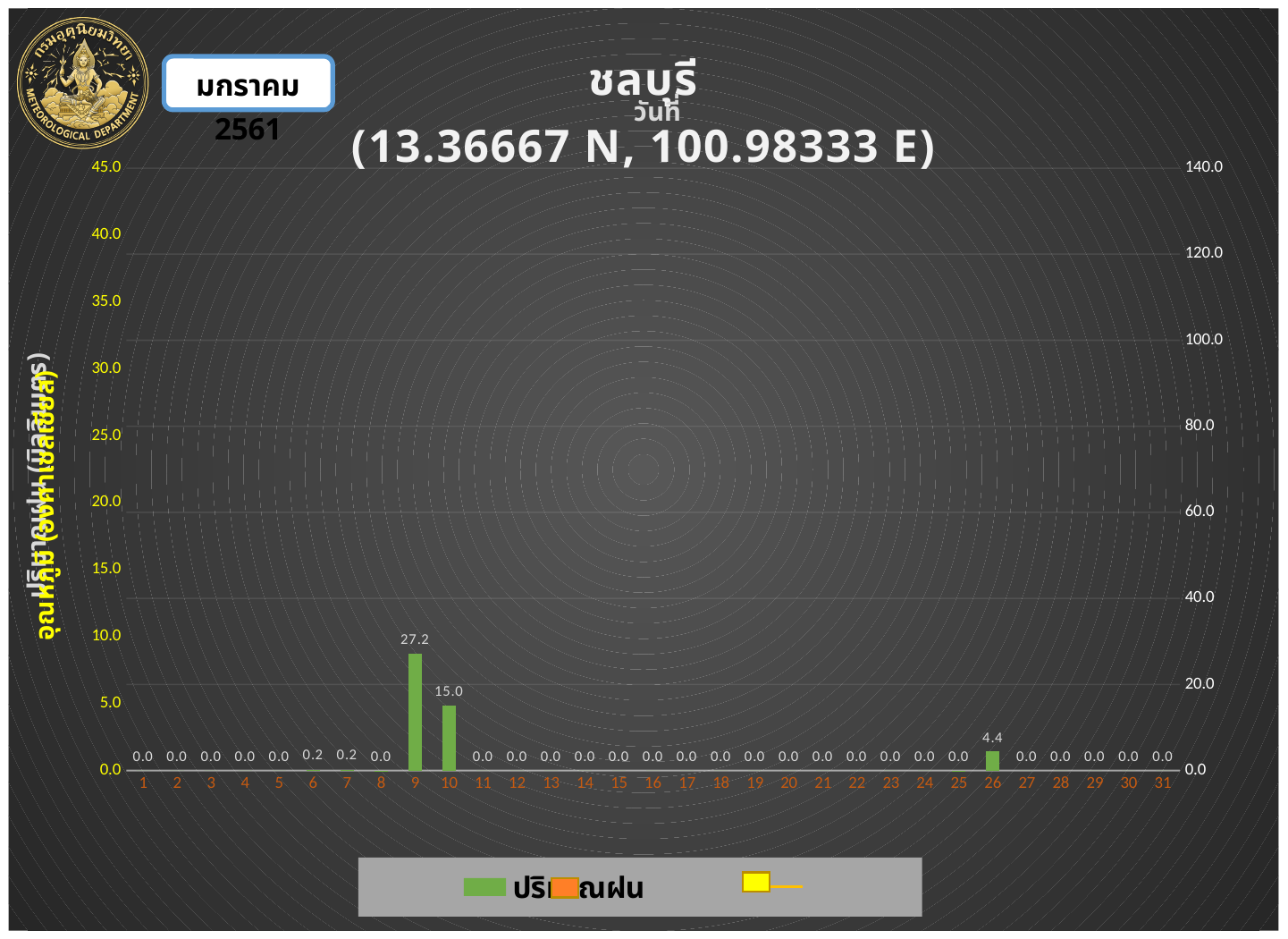
What coordinates are given in the chart title? 13.36667 N, 100.98333 E What is the difference between the rainfall values for day 9 and day 10? 12.2 What kind of chart is shown on the slide? bar chart How many days are shown on the x axis? 31 Which day has the larger rainfall value, day 10 or day 26? 10 What is the rainfall value shown for day 9? 27.2 What is the rainfall value shown for day 10? 15.0 What is the rainfall value shown for day 15? 0.0 What is the rainfall value shown for day 6? 0.2 What is the rainfall value shown for day 26? 4.4 Which day has the highest rainfall value? 9 What is the difference between the rainfall values for day 9 and day 26? 22.8